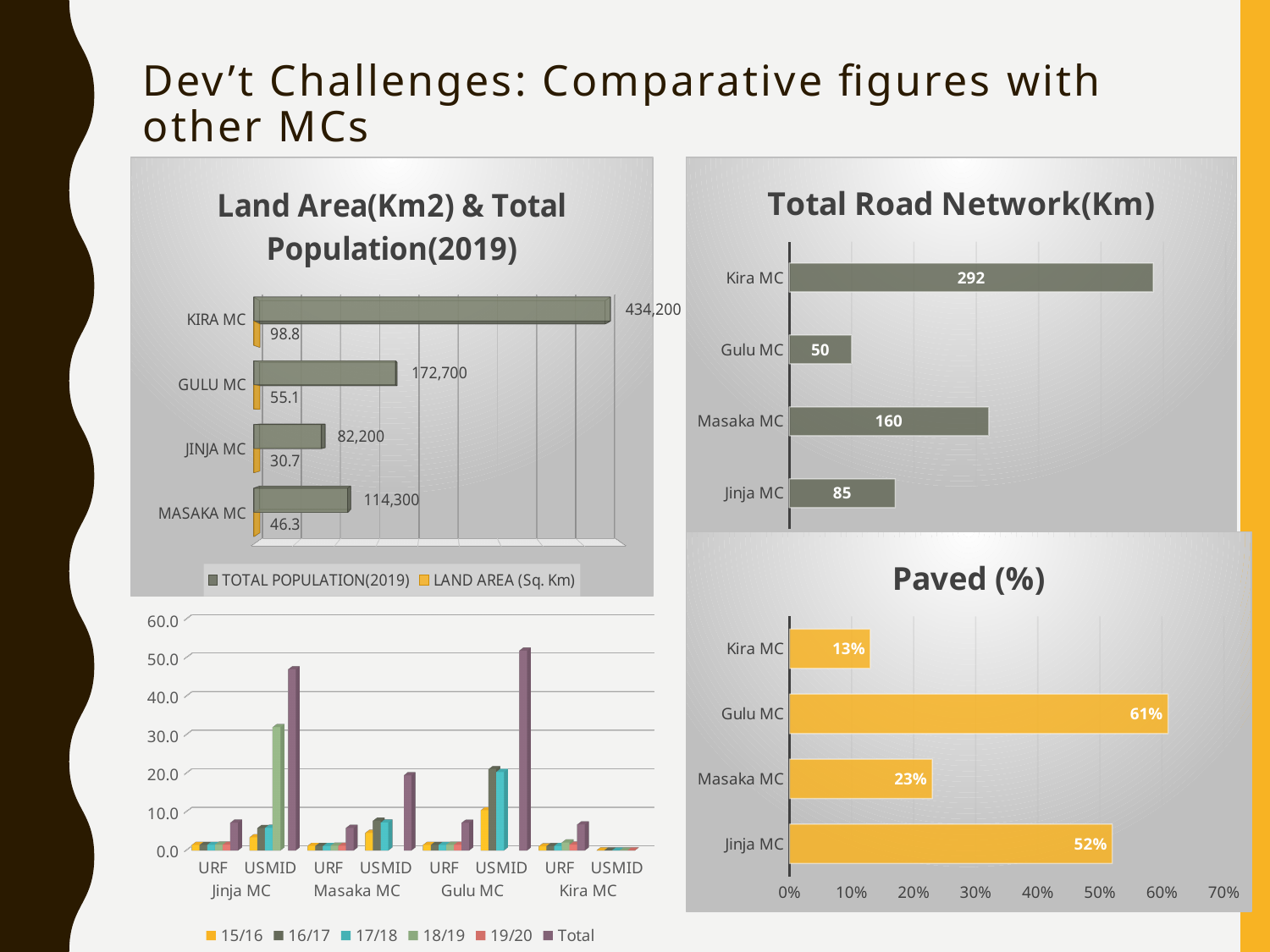
In the 'Land Area(Km2) & Total Population(2019)' chart, what is the total population of KIRA MC? 434,200 In the 'Total Road Network(Km)' chart, which MC has the largest road network? Kira MC In the 'Paved (%)' chart, which MC has the lowest paved percentage? Kira MC In the bottom-left chart, how many series does the legend list? 6 In the 'Total Road Network(Km)' chart, how much larger is Kira MC's road network than Jinja MC's? 207 In the 'Paved (%)' chart, which is larger, the value for Masaka MC or Jinja MC? Jinja MC In the 'Land Area(Km2) & Total Population(2019)' chart, which MC has the lowest total population? JINJA MC In the 'Land Area(Km2) & Total Population(2019)' chart, what is the difference in land area between GULU MC and MASAKA MC? 8.8 In the 'Paved (%)' chart, what is the paved percentage for Gulu MC? 61% In the 'Land Area(Km2) & Total Population(2019)' chart, what is the land area of JINJA MC? 30.7 In the 'Total Road Network(Km)' chart, what is the value for Masaka MC? 160 In the bottom-left chart, is the Total value for USMID under Jinja MC greater or less than 50.0? less